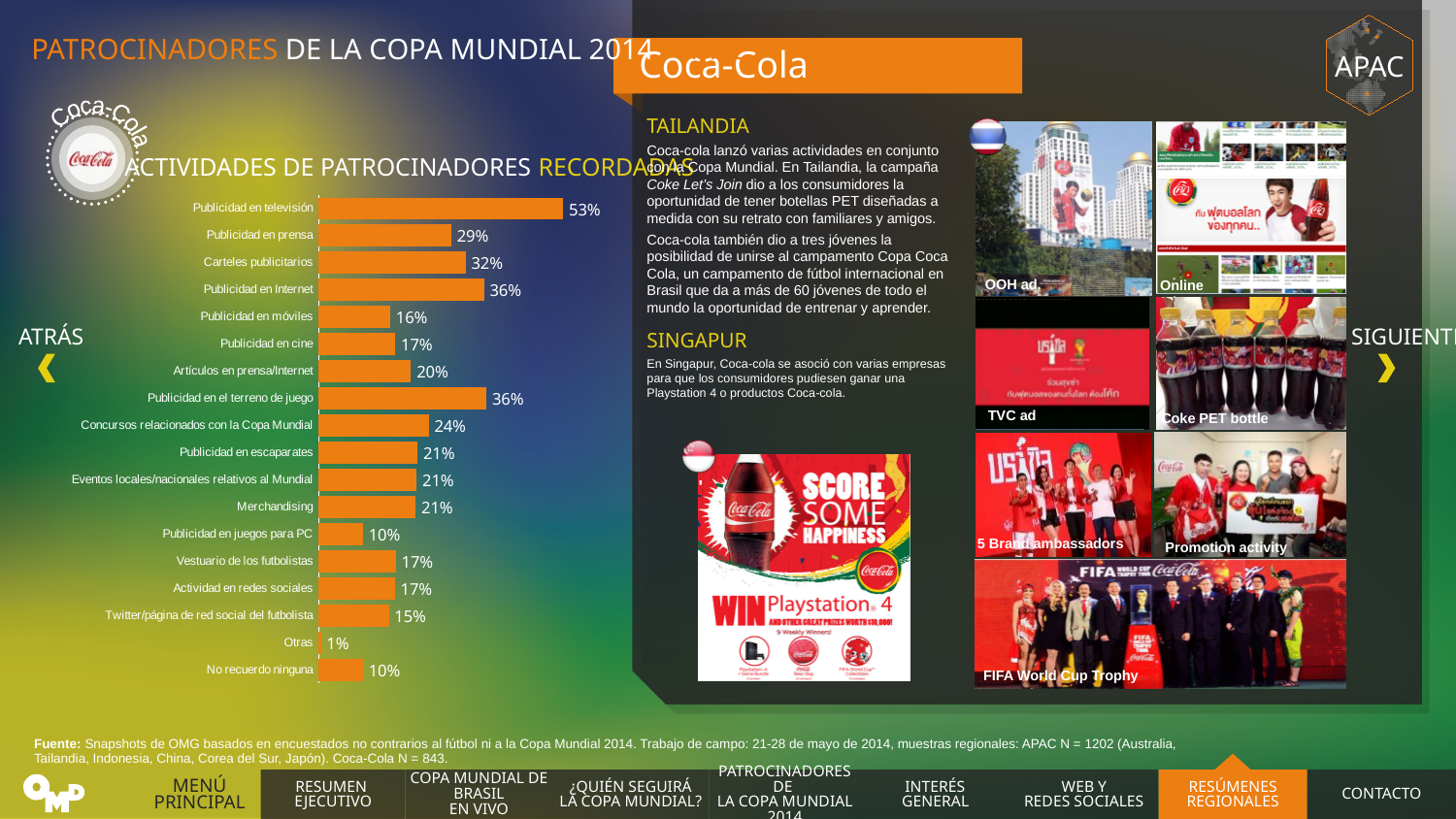
What kind of chart is shown on the left of the slide? Bar chart What is the value for No recuerdo ninguna? 10% What is the value for Twitter/página de red social del futbolista? 15% What is the value for Publicidad en televisión? 53% Which category has the highest value? Publicidad en televisión What is the title of the chart? ACTIVIDADES DE PATROCINADORES RECORDADAS Which is larger, Carteles publicitarios or Publicidad en prensa? Carteles publicitarios What is the difference between Publicidad en televisión and Publicidad en Internet? 17% What is the value for Concursos relacionados con la Copa Mundial? 24% Which category has the lowest value? Otras What is the value for Publicidad en prensa? 29% How many categories are shown in the bar chart? 18